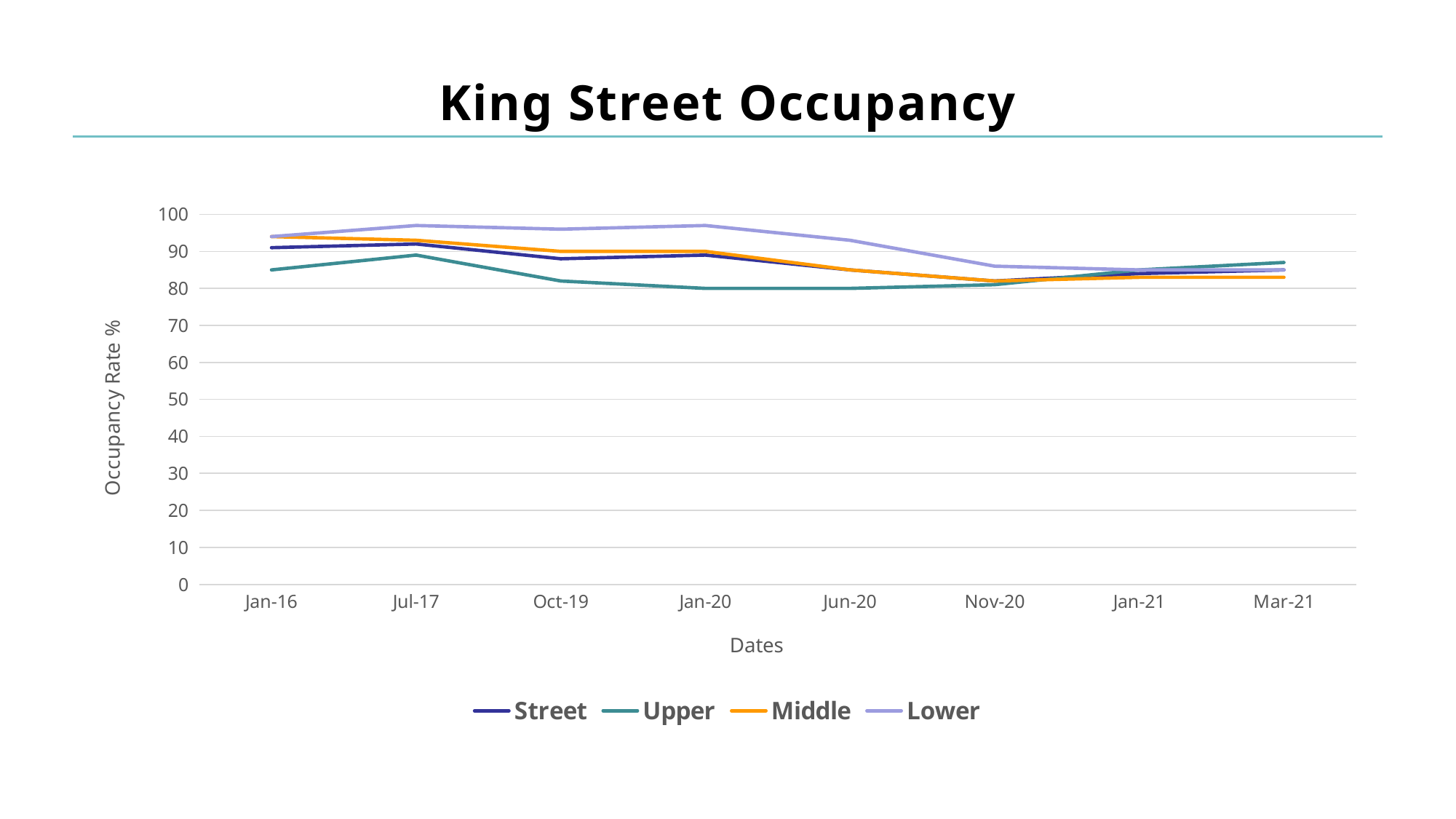
Which series has the highest value at Jul-17? Lower Is the value for Street at Jan-16 greater or less than 80? greater How many dates are plotted along the x axis? 8 Which series has the lowest value at Jan-20? Upper Is the value for Lower at Jul-17 greater or less than 90? greater How many series does the legend list? 4 Does the Lower series rise or fall between Jan-20 and Nov-20? fall Is the value for Upper at Jan-20 greater or less than 90? less At Jan-16, which is larger: the value for Lower or the value for Upper? Lower What is the title of the chart? King Street Occupancy What is the title of the y axis? Occupancy Rate % What kind of chart is shown on the slide? line chart